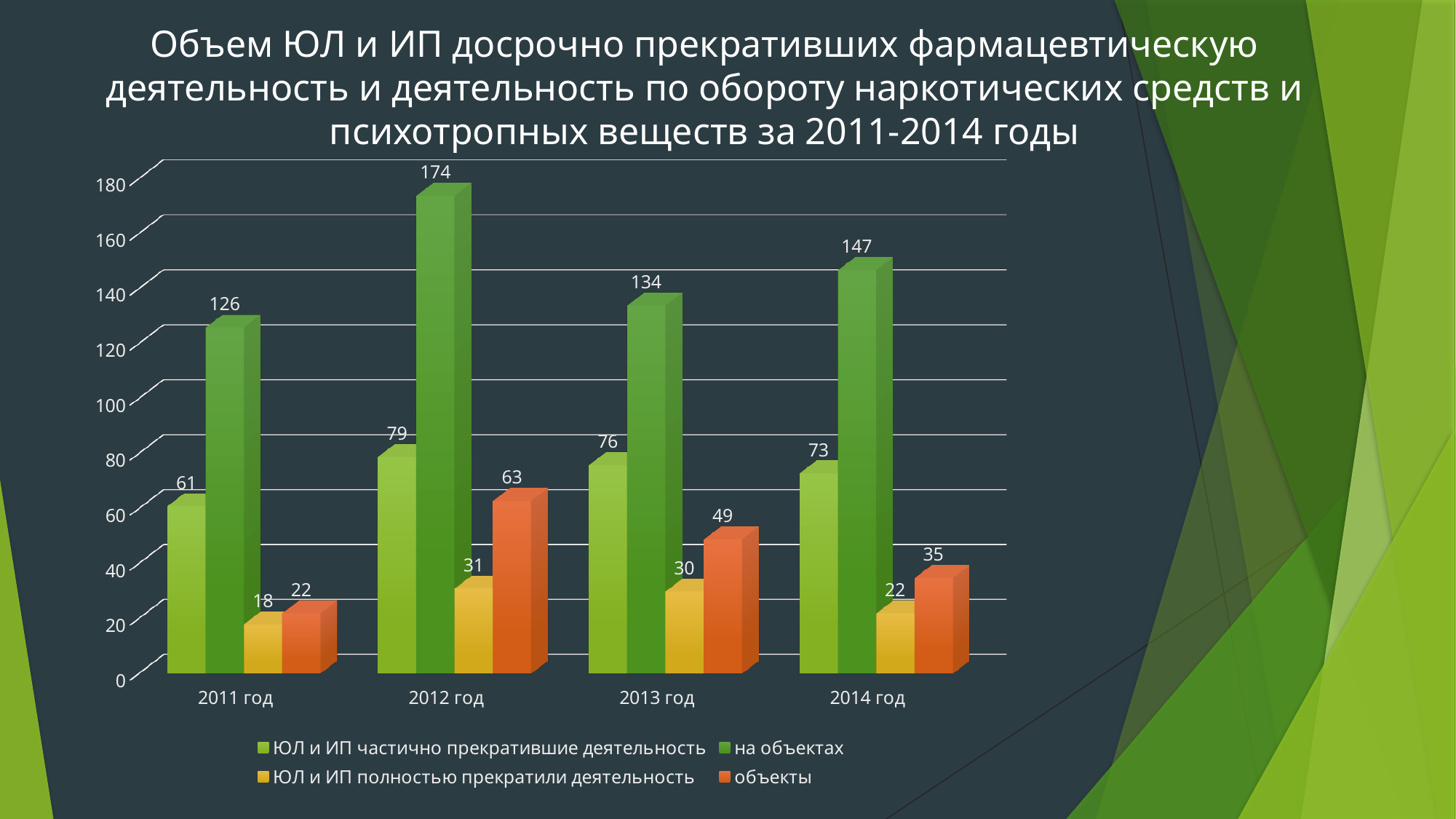
What is the value for "на объектах" in 2012 год? 174 What kind of chart is shown on the slide? Bar chart What is the difference between the "на объектах" values for 2012 год and 2011 год? 48 In which year is the value for "на объектах" the highest? 2012 год How many series does the legend list? 4 In which year is the value for "ЮЛ и ИП частично прекратившие деятельность" the lowest? 2011 год What is the value for "ЮЛ и ИП полностью прекратили деятельность" in 2013 год? 30 What is the value for "объекты" in 2014 год? 35 How many years are shown on the x axis? 4 Does the value for "ЮЛ и ИП частично прекратившие деятельность" rise or fall from 2012 год to 2014 год? Fall Which series is shown in orange in the legend? объекты Which is larger: the "объекты" value for 2012 год or for 2013 год? 2012 год